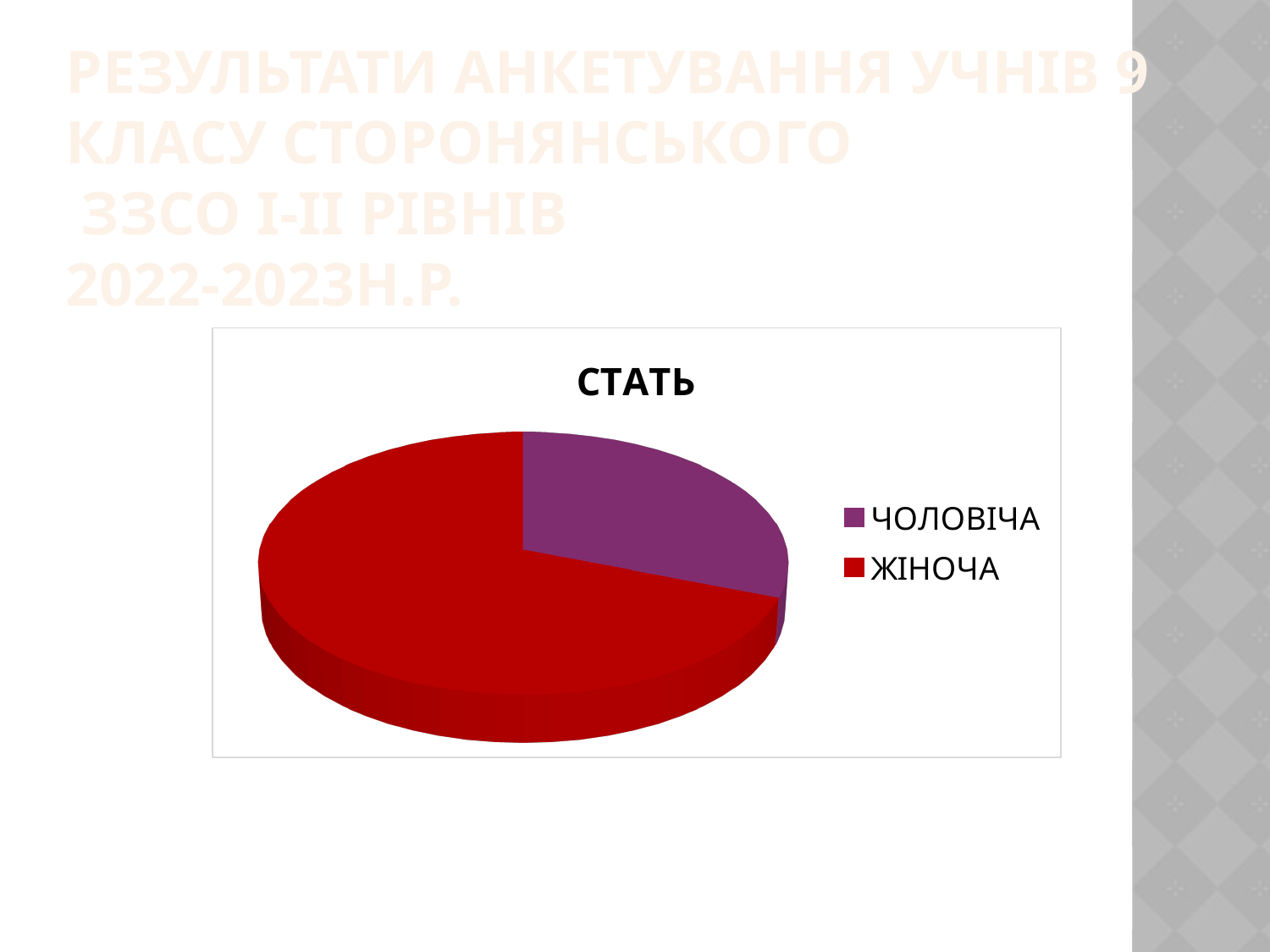
What is the title of the chart? СТАТЬ Which slice is larger, ЧОЛОВІЧА or ЖІНОЧА? ЖІНОЧА How many slices does the pie chart have? 2 How many entries does the legend list? 2 Which category has the largest slice of the pie? ЖІНОЧА What colour is the ЖІНОЧА slice? red Which category has the smallest slice of the pie? ЧОЛОВІЧА What kind of chart is shown on the slide? pie chart Does the ЖІНОЧА slice take up more or less than half of the pie? more